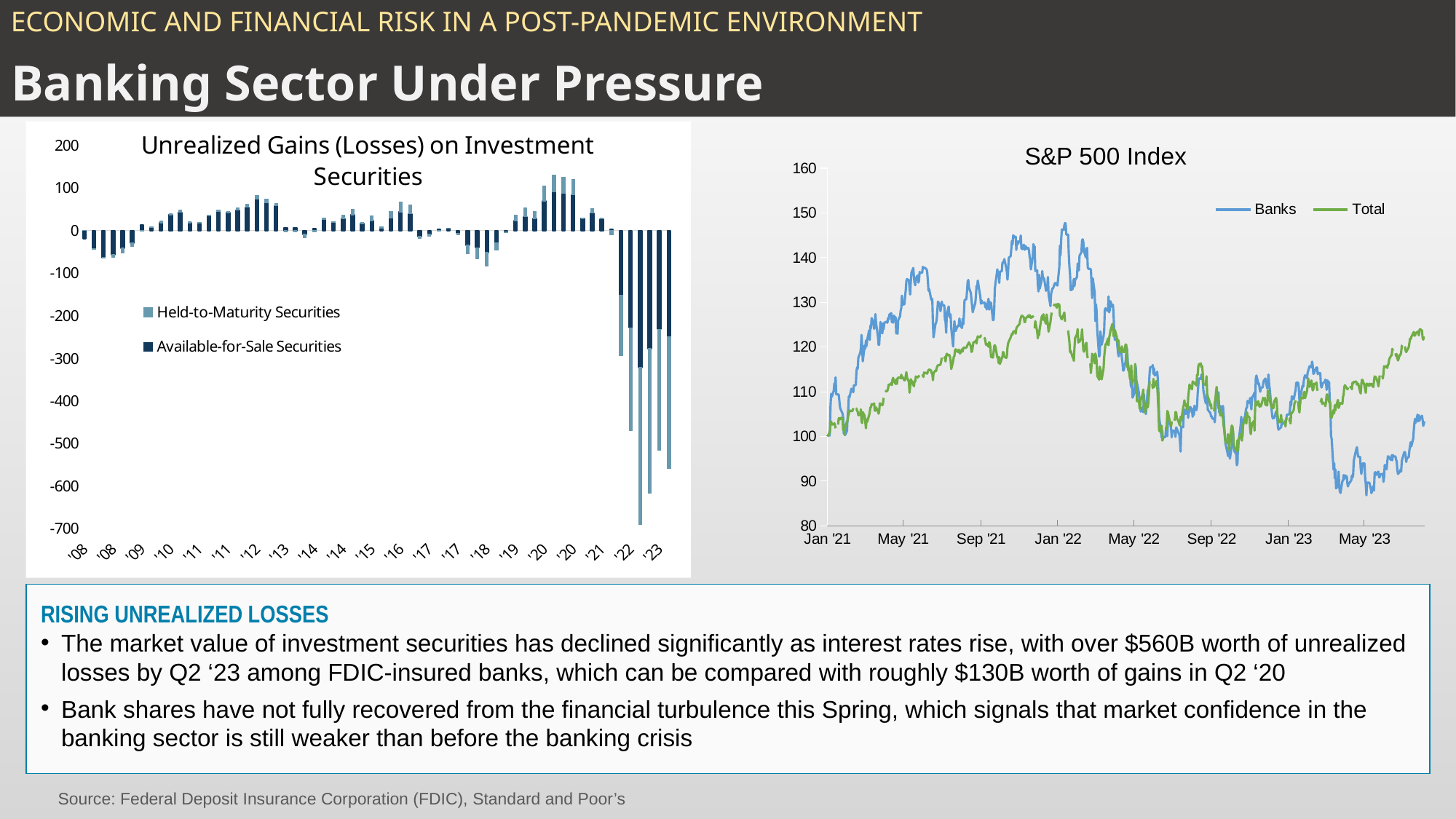
In the 'Unrealized Gains (Losses) on Investment Securities' chart, do the stacked bar totals rise or fall from '21 to '22? fall In the 'Unrealized Gains (Losses) on Investment Securities' chart, what are the two series named in the legend? Held-to-Maturity Securities and Available-for-Sale Securities How many series does the legend of the 'Unrealized Gains (Losses) on Investment Securities' chart list? 2 In the 'S&P 500 Index' chart, which series is higher around Jan '22, Banks or Total? Banks In the 'S&P 500 Index' chart, which series is drawn in green? Total In the 'Unrealized Gains (Losses) on Investment Securities' chart, is the lowest stacked bar total in '22 greater or less than -600? less In the 'S&P 500 Index' chart, is the peak value of the Banks series around Jan '22 greater or less than 140? greater What kind of chart is the 'Unrealized Gains (Losses) on Investment Securities' chart on the left? bar chart How many series does the legend of the 'S&P 500 Index' chart list? 2 In the 'S&P 500 Index' chart, is the Banks series around May '23 greater or less than 100? less In the 'S&P 500 Index' chart, which series is higher around May '23, Banks or Total? Total What kind of chart is the 'S&P 500 Index' chart on the right? line chart